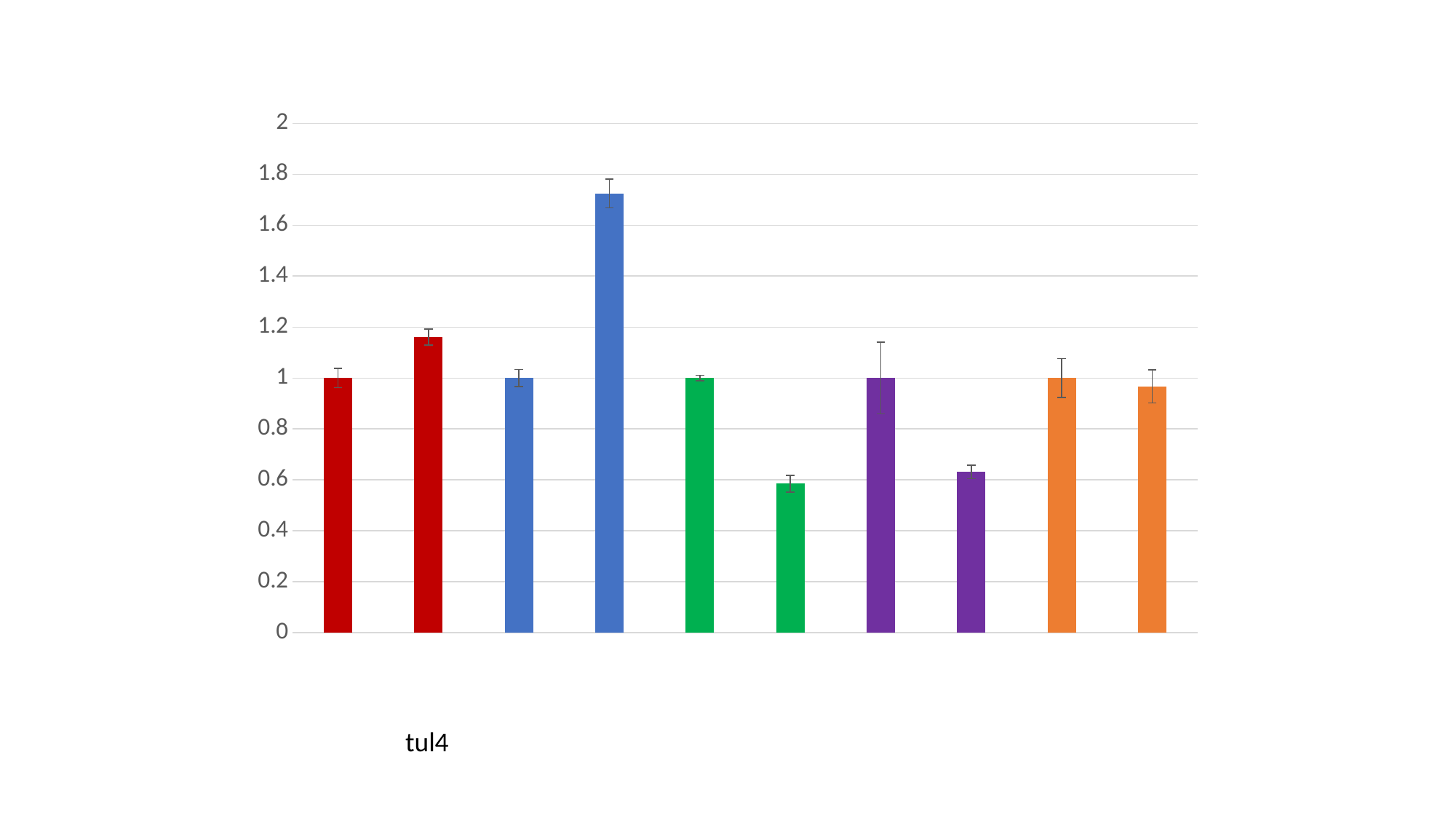
How many different bar colours are used in the chart? 5 How many bars are plotted in the chart? 10 What value does the first red bar reach on the y axis? 1 Which is larger, the second green bar or the second orange bar? the second orange bar Which bar is the highest in the chart? the second blue bar Is the value of the second purple bar greater or less than 0.8? less Is the value of the second green bar greater or less than 0.8? less Is the value of the second red bar greater or less than 1? greater What kind of chart is shown on the slide? bar chart Which is larger, the second blue bar or the second red bar? the second blue bar What text label appears below the chart? tul4